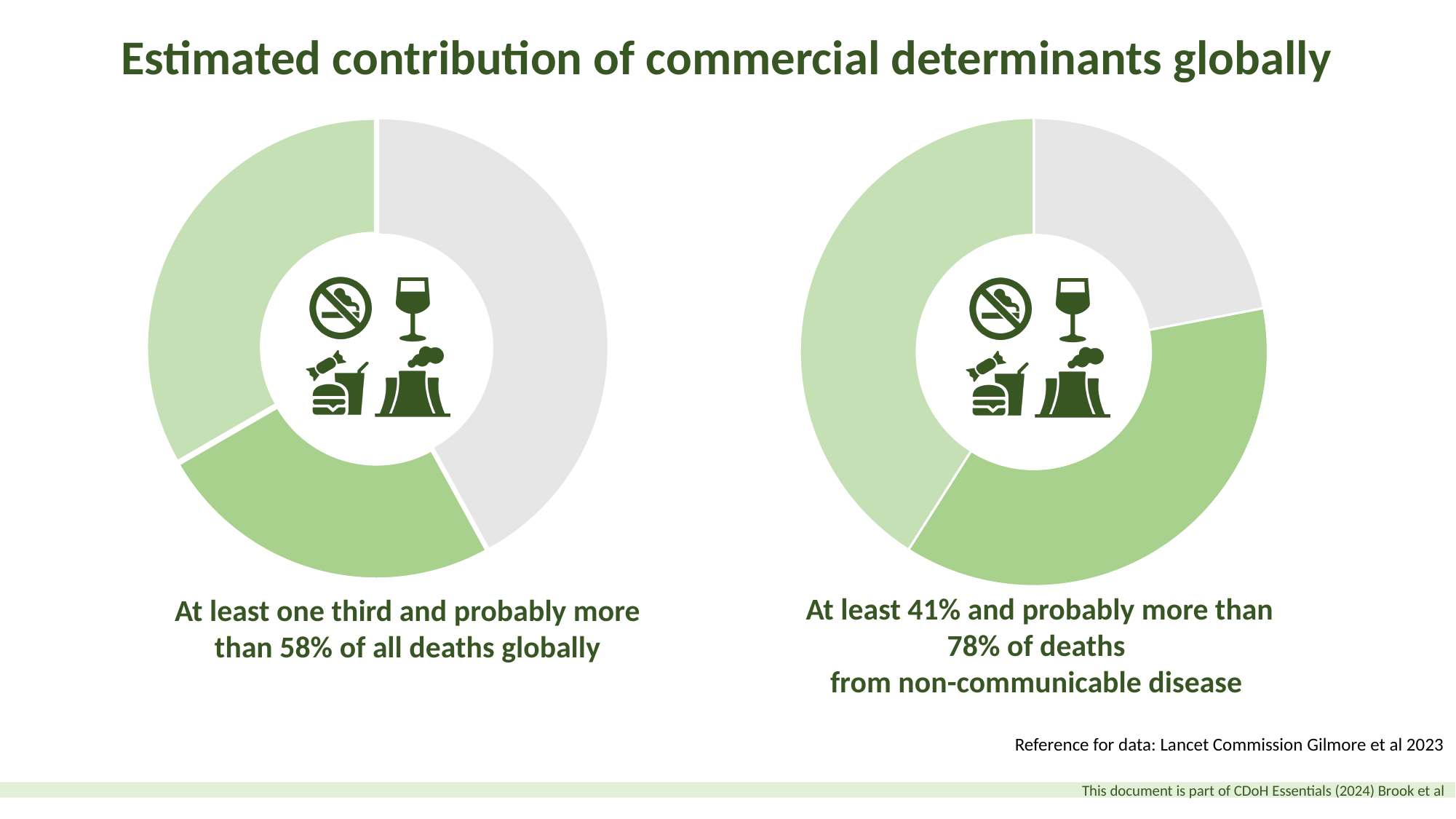
Is the dark green slice larger in the left donut chart or the right donut chart? Right How many slices does the left donut chart (all deaths globally) have? 3 What type of chart is used on the right of the slide? Pie (donut) chart What is the title of the slide? Estimated contribution of commercial determinants globally According to the caption under the right donut chart, commercial determinants contribute to at least what percentage of deaths from non-communicable disease? 41% In the left donut chart (all deaths globally), which colour slice is the largest? Grey In the right donut chart (deaths from non-communicable disease), which colour slice is the smallest? Grey What type of chart is used on the left of the slide? Pie (donut) chart How many slices does the right donut chart (deaths from non-communicable disease) have? 3 In the left donut chart (all deaths globally), which colour slice is the smallest? Dark green Is the grey slice larger in the left donut chart or the right donut chart? Left